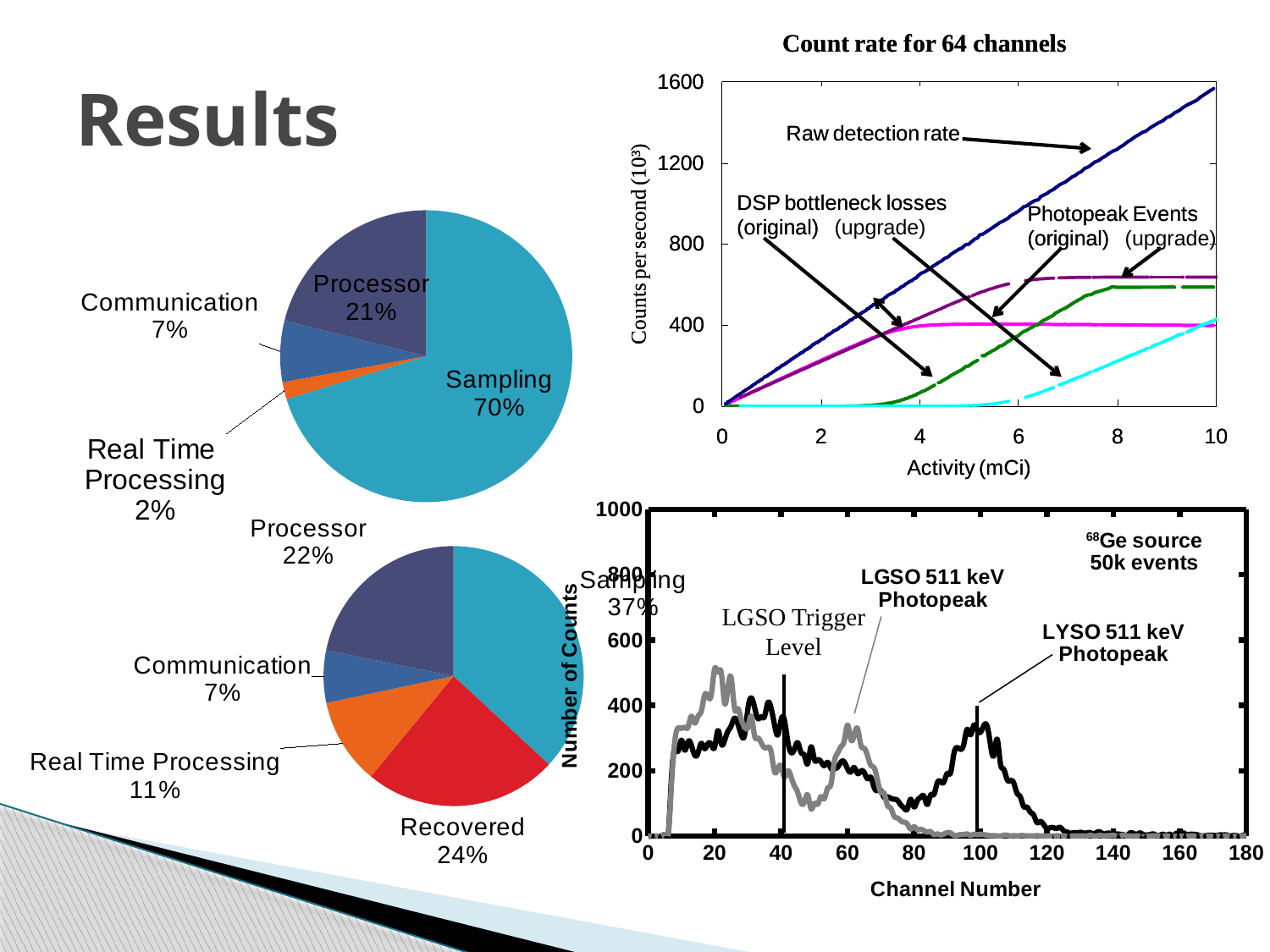
In the upper pie chart on the left, what share does Sampling have? 70% In the upper pie chart on the left, what is the difference between the Processor share and the Communication share? 14% In the lower pie chart on the left, what share does Recovered have? 24% In the lower pie chart on the left, which is larger, Real Time Processing or Communication? Real Time Processing In the lower pie chart on the left, how many slices are there? 5 In the chart titled 'Count rate for 64 channels', does the Raw detection rate rise or fall as activity increases? rise In the lower pie chart on the left, which category has the largest share? Sampling In the upper pie chart on the left, how many slices are there? 4 In the upper pie chart on the left, which category has the smallest share? Real Time Processing In the chart titled 'Count rate for 64 channels', what is the label of the x axis? Activity (mCi) In the chart titled 'Count rate for 64 channels', is the Raw detection rate at 10 mCi greater or less than 1200? greater In the bottom-right chart, what is the label of the x axis? Channel Number